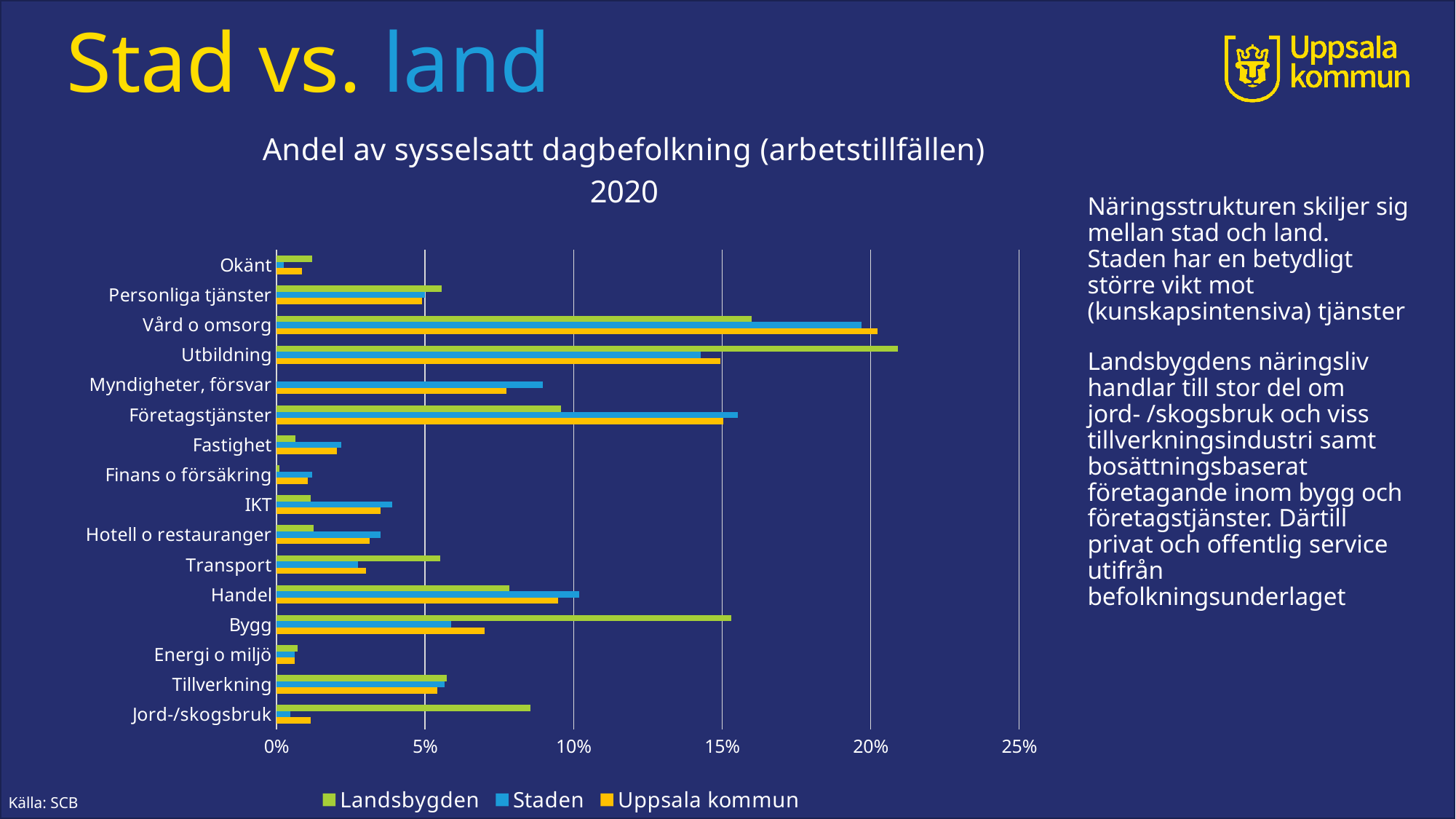
Is the value for Transport for Staden greater or less than 5%? less What kind of chart is shown on the slide? Bar chart What is the title of the chart? Andel av sysselsatt dagbefolkning (arbetstillfällen) 2020 Is the value for Jord-/skogsbruk for Landsbygden greater or less than 5%? greater Is the value for Utbildning for Landsbygden greater or less than 20%? greater Which category has the highest value for Staden? Vård o omsorg For Bygg, which is larger: the value for Landsbygden or the value for Staden? Landsbygden How many categories (industries) are shown on the vertical axis of the chart? 16 How many series does the legend list? 3 For Jord-/skogsbruk, which is larger: the value for Landsbygden or the value for Staden? Landsbygden Which category has the highest value for Landsbygden? Utbildning Which series is shown in orange in the chart? Uppsala kommun